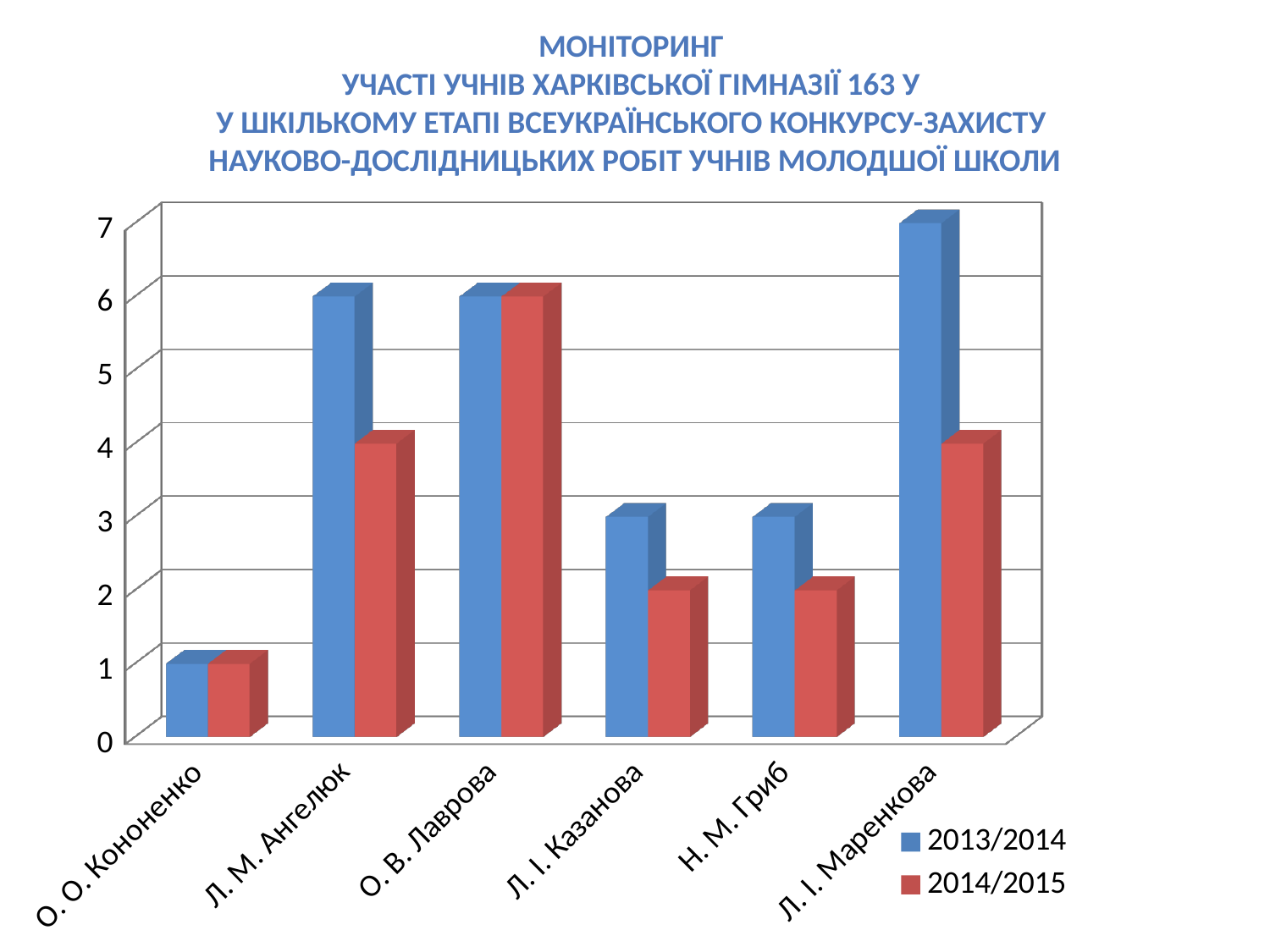
How many series does the legend list? 2 How many teachers (categories) are shown on the x axis? 6 Which teacher has the highest value for 2013/2014? Л. І. Маренкова Is the value for Л. І. Казанова in 2014/2015 greater or less than 3? less What kind of chart is shown on the slide? bar chart What is the value for Л. І. Маренкова in 2013/2014? 7 Which colour represents the 2014/2015 series in the legend? red What is the value for О. О. Кононенко in 2013/2014? 1 Which is larger for Л. М. Ангелюк: the 2013/2014 value or the 2014/2015 value? 2013/2014 Is the value for Л. І. Маренкова in 2013/2014 greater or less than 5? greater Which teacher has the lowest value for 2014/2015? О. О. Кононенко What is the value for Л. М. Ангелюк in 2014/2015? 4